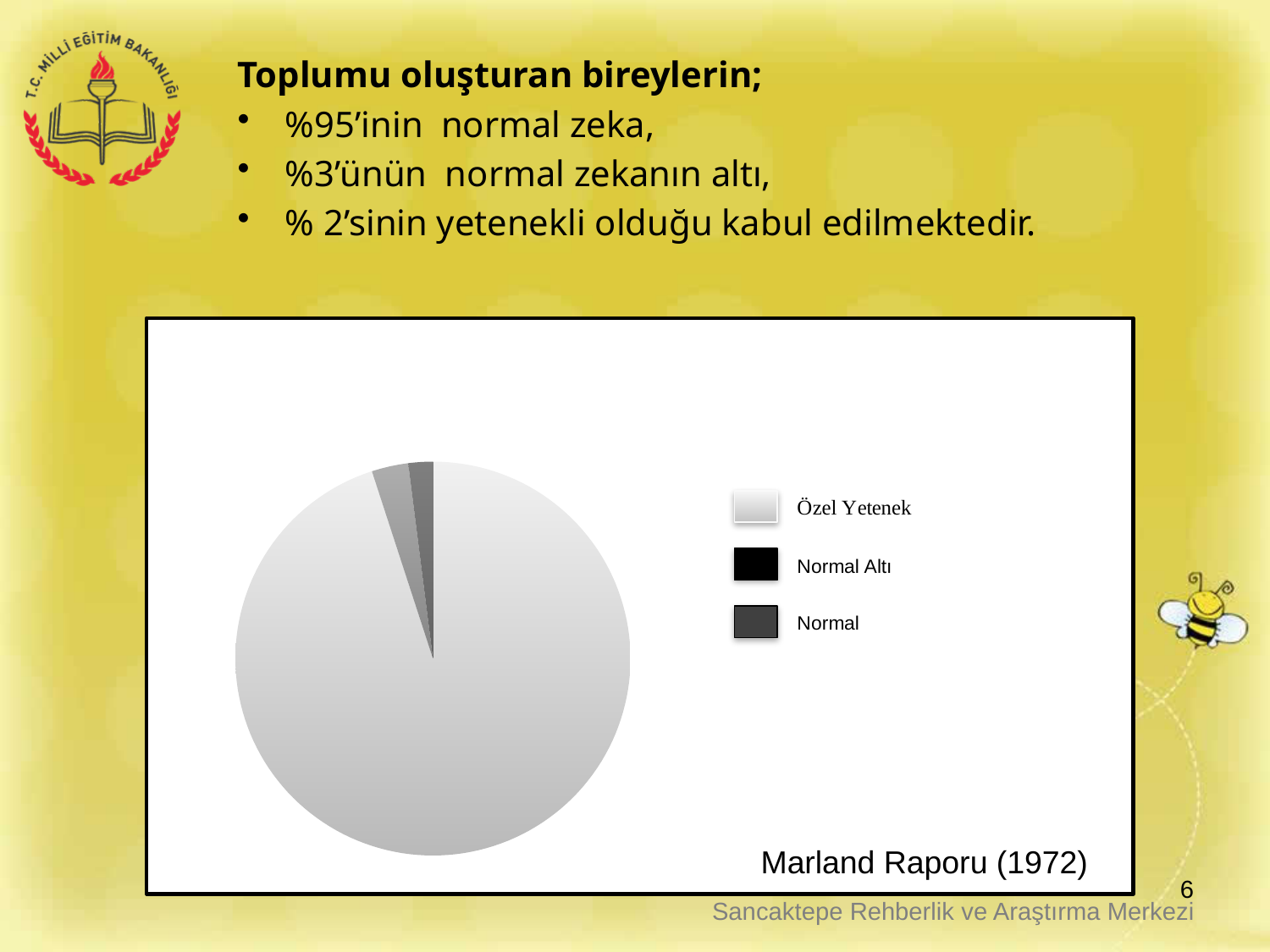
What are the three legend entries of the pie chart? Özel Yetenek, Normal Altı, Normal What source caption is printed in the bottom right corner of the chart area? Marland Raporu (1972) Is the largest slice of the pie chart light grey or dark grey? light grey How many entries does the legend of the pie chart list? 3 How many slices does the pie chart have? 3 What kind of chart is shown on the slide? pie chart